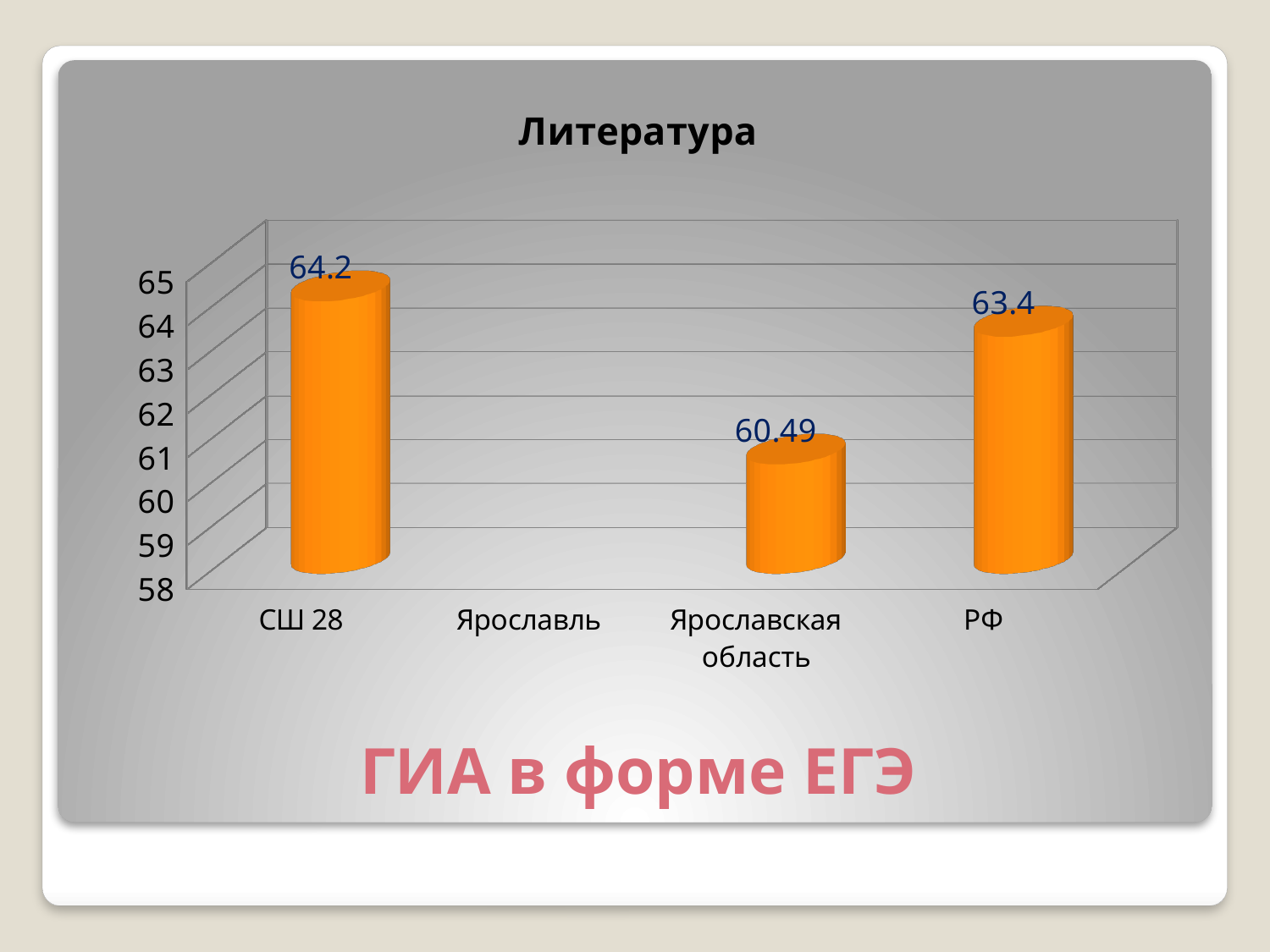
Which is larger, the value for СШ 28 or the value for РФ? СШ 28 Which category with a plotted bar has the lowest value? Ярославская область What is the value for РФ? 63.4 What kind of chart is shown on the slide? bar chart Which category has the highest value? СШ 28 What is the value for Ярославская область? 60.49 What is the difference between the values for СШ 28 and РФ? 0.8 How many categories are labelled on the x axis? 4 What is the difference between the values for РФ and Ярославская область? 2.91 Is the value for Ярославская область greater or less than 62? less What is the value for СШ 28? 64.2 What is the title of the chart? Литература